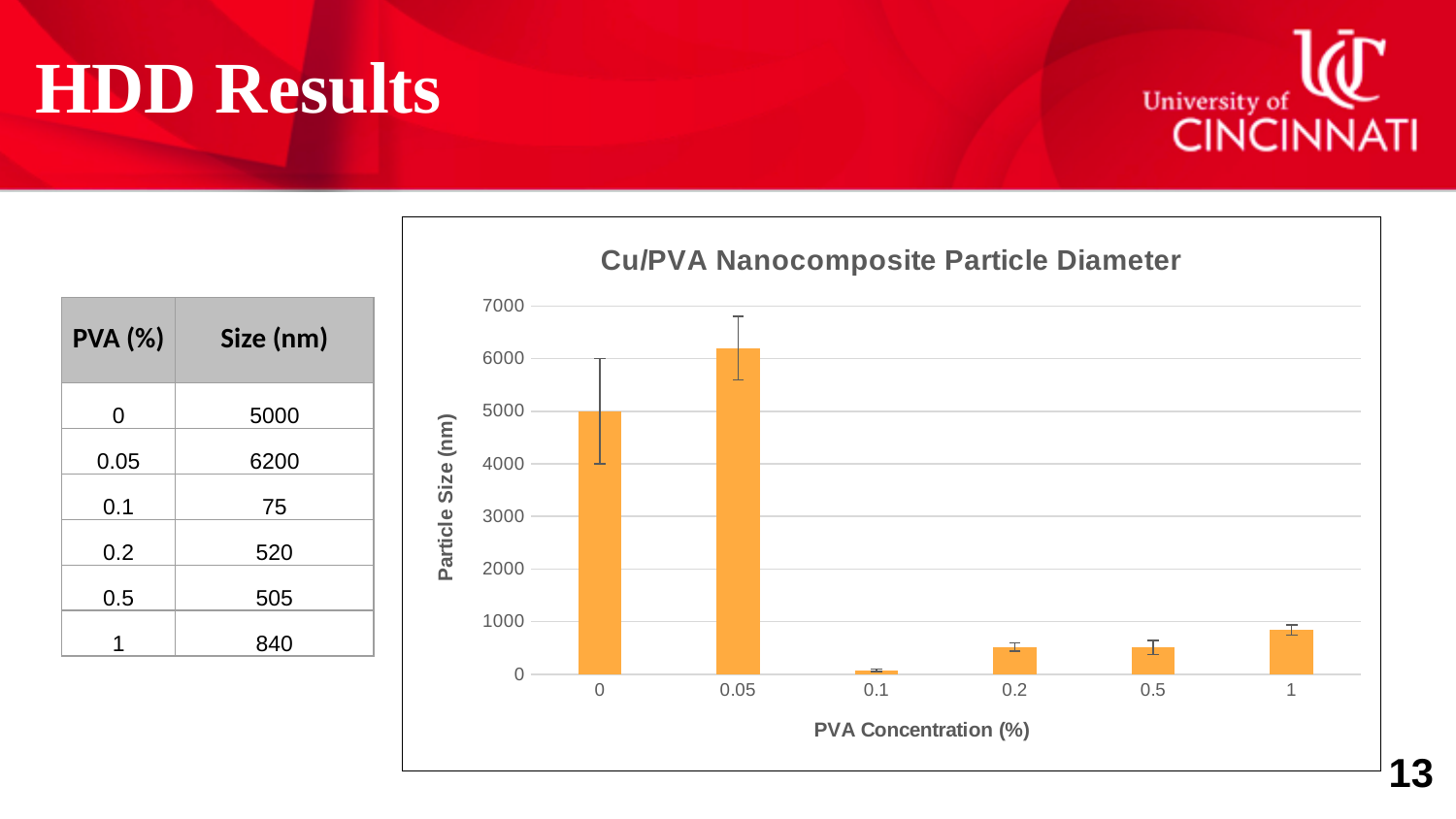
Is the particle size for PVA concentration 0.05 greater or less than 6000 nm? greater What type of chart is shown on the slide? bar chart What is the label of the y axis of the chart? Particle Size (nm) Is the particle size for PVA concentration 0 greater or less than 4000 nm? greater Which has a larger particle size, PVA concentration 0 or PVA concentration 0.05? 0.05 Which PVA concentration has the largest particle size in the chart? 0.05 According to the table on the slide, what is the particle size for PVA concentration 0.2? 520 Which has a larger particle size, PVA concentration 0.2 or PVA concentration 1? 1 How many PVA concentration categories are plotted on the x axis of the chart? 6 Is the particle size for PVA concentration 1 greater or less than 1000 nm? less Which PVA concentration has the smallest particle size in the chart? 0.1 What is the title of the chart? Cu/PVA Nanocomposite Particle Diameter